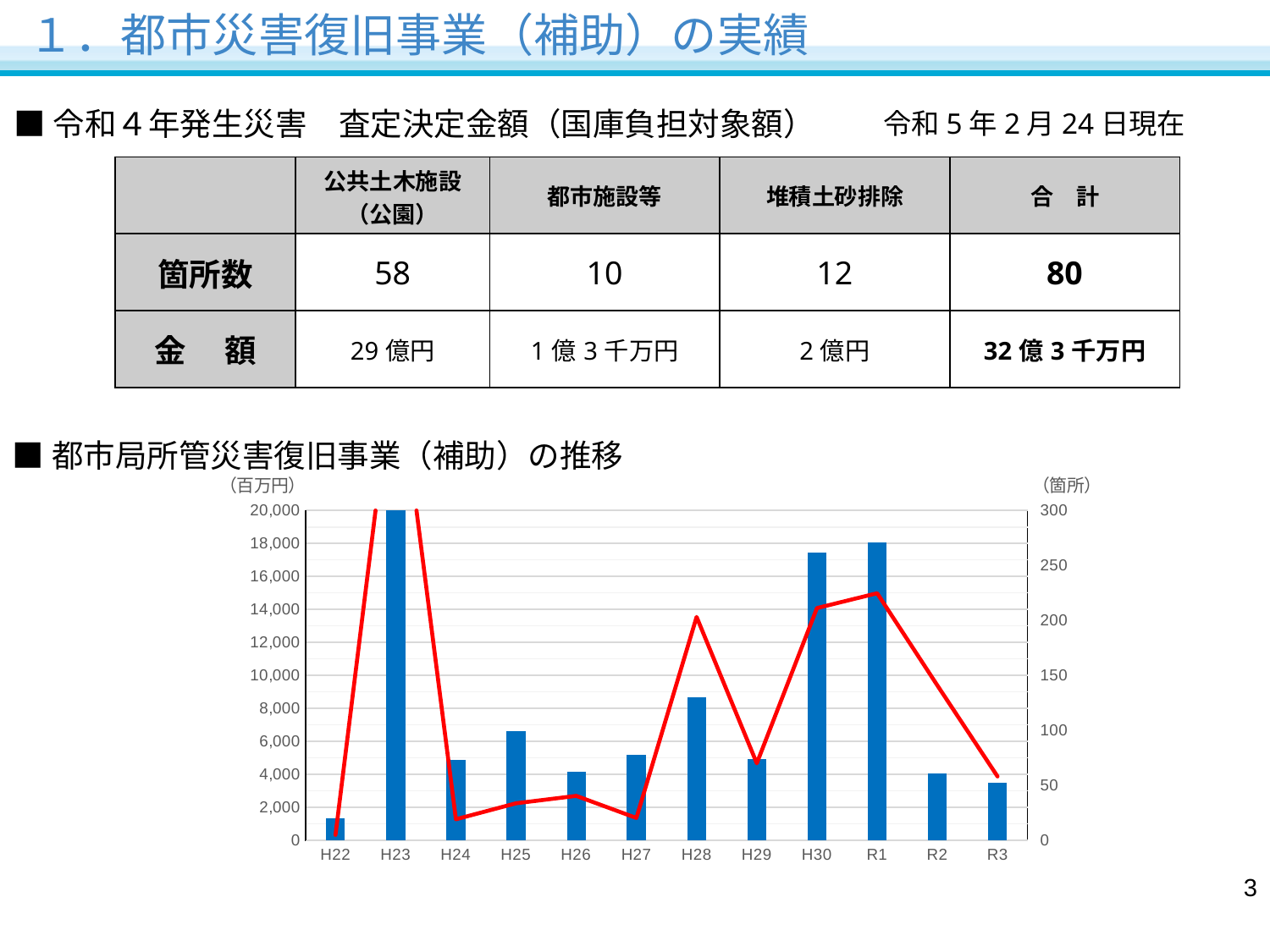
What unit is shown for the left vertical axis of the chart? 百万円 Which year has the shortest bar in the chart? H22 Is the bar value for H28 greater or less than 6,000? greater Is the red line value for R1 greater or less than 200 (箇所)? greater Is the bar value for H30 greater or less than 16,000? greater Which year has the tallest bar in the chart? H23 What kind of chart is shown under the heading 都市局所管災害復旧事業（補助）の推移? A bar chart combined with a line Do the bar values rise or fall from R1 to R3? fall Which bar is taller, H30 or H28? H30 How many fiscal-year categories are shown on the x axis of the chart? 12